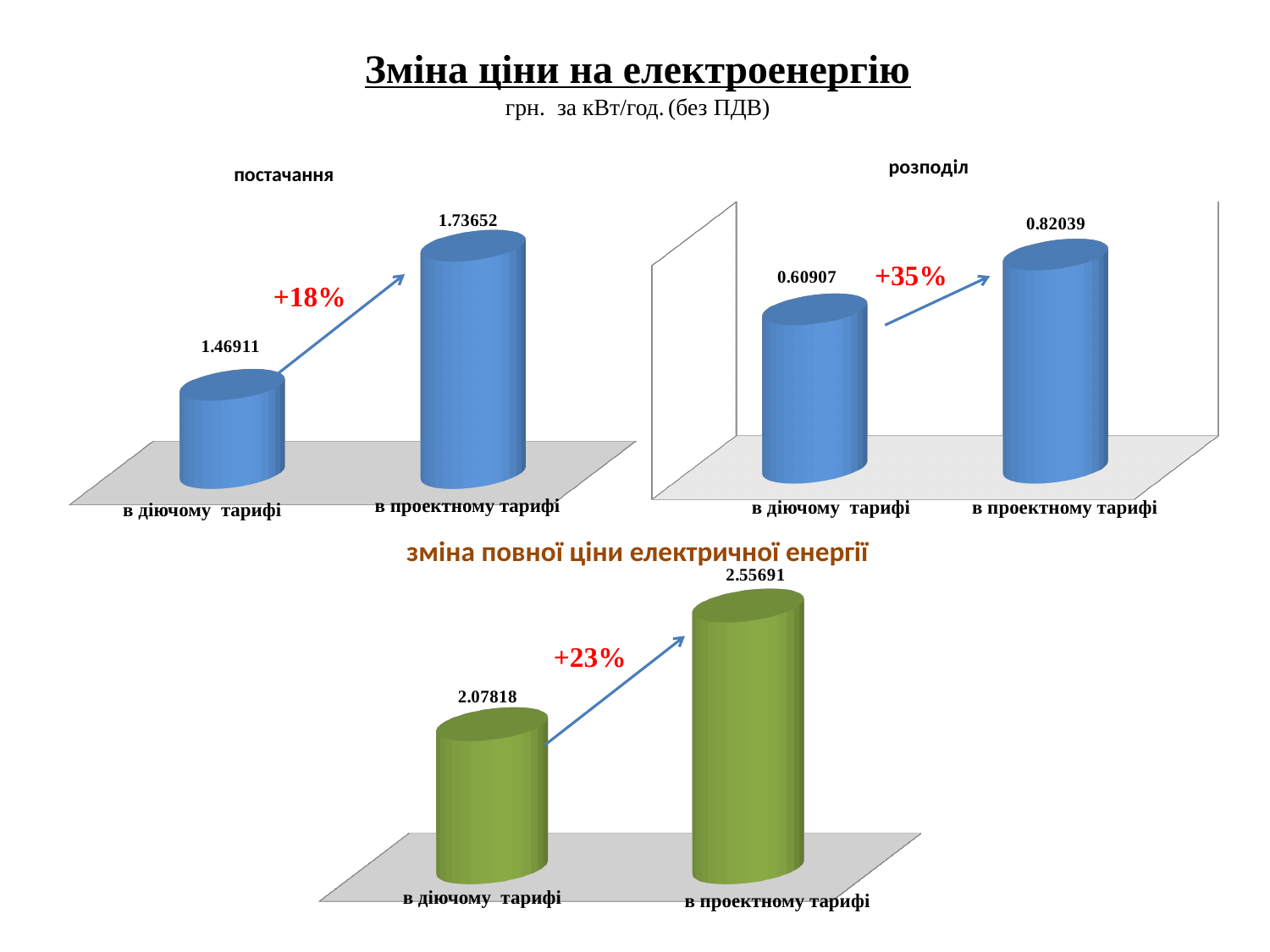
In the chart titled "постачання", what is the value for "в проектному тарифі"? 1.73652 In the chart titled "зміна повної ціни електричної енергії", what is the value for "в діючому тарифі"? 2.07818 In the chart titled "розподіл", what is the difference between the value for "в проектному тарифі" and the value for "в діючому тарифі"? 0.21132 In the chart titled "розподіл", which category has the lowest value? в діючому тарифі In the chart titled "постачання", what is the value for "в діючому тарифі"? 1.46911 What type of chart is the chart titled "зміна повної ціни електричної енергії"? bar chart In the chart titled "зміна повної ціни електричної енергії", which category has the higher value? в проектному тарифі In the chart titled "розподіл", what is the value for "в проектному тарифі"? 0.82039 How many categories are shown in the chart titled "постачання"? 2 In the chart titled "постачання", what is the difference between the value for "в проектному тарифі" and the value for "в діючому тарифі"? 0.26741 In the chart titled "розподіл", what is the value for "в діючому тарифі"? 0.60907 In the chart titled "зміна повної ціни електричної енергії", what is the value for "в проектному тарифі"? 2.55691